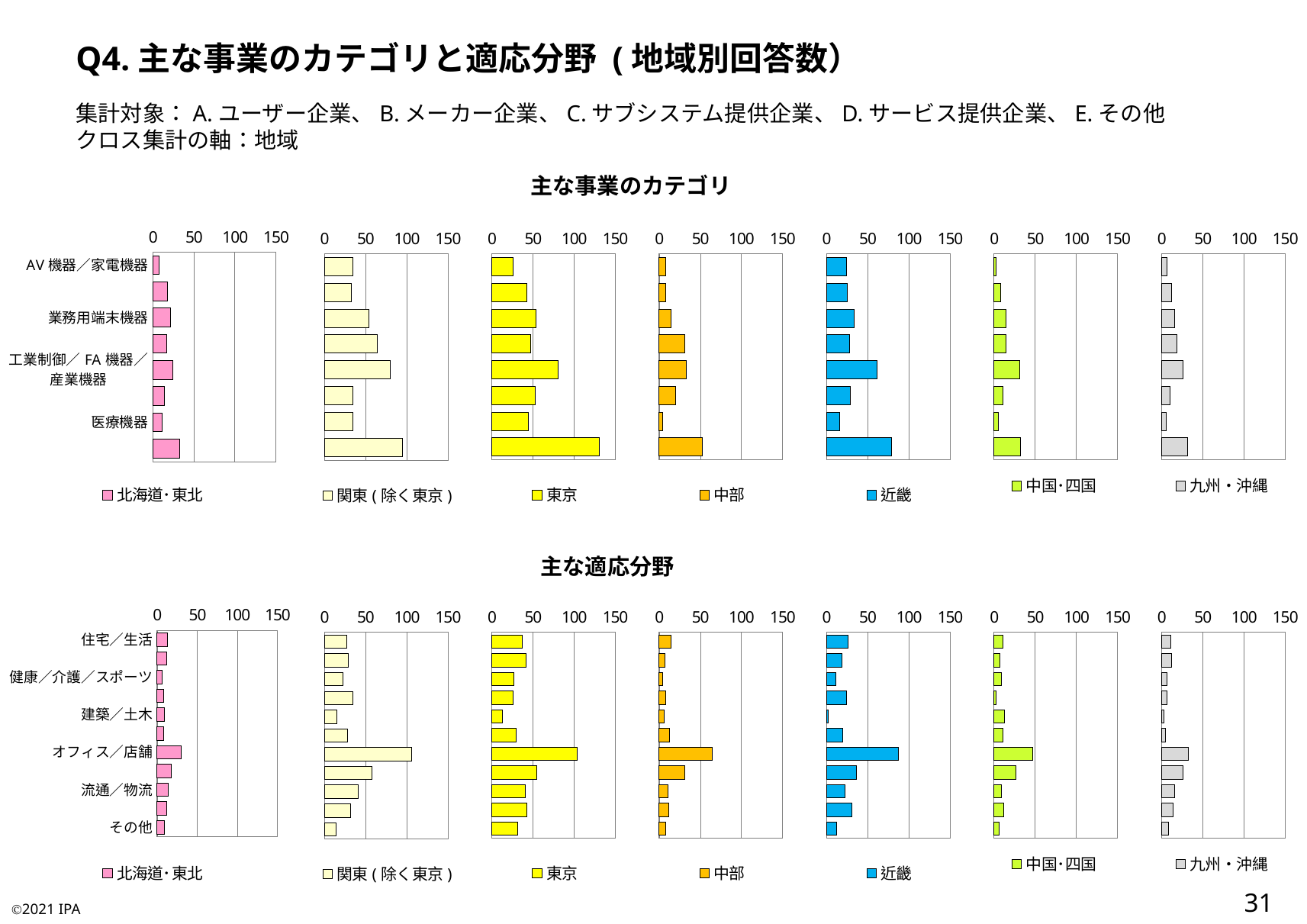
For オフィス／店舗 in 主な適応分野, which region has the larger value, 近畿 or 九州・沖縄? 近畿 What kind of chart is used for 主な事業のカテゴリ? bar chart In the 主な適応分野 九州・沖縄 chart, is the value for オフィス／店舗 greater or less than 50? less In the 主な適応分野 charts, which region is shown in blue according to the legend? 近畿 For 工業制御／FA機器／産業機器 in 主な事業のカテゴリ, which region has the larger value, 東京 or 中部? 東京 In the 主な適応分野 近畿 chart, is the value for オフィス／店舗 greater or less than 50? greater In the 主な適応分野 東京 chart, which category has the highest value? オフィス／店舗 In the 主な事業のカテゴリ 関東(除く東京) chart, is the value for 工業制御／FA機器／産業機器 greater or less than 50? greater How many regional charts are shown under 主な事業のカテゴリ? 7 In the 主な適応分野 近畿 chart, which category has the highest value? オフィス／店舗